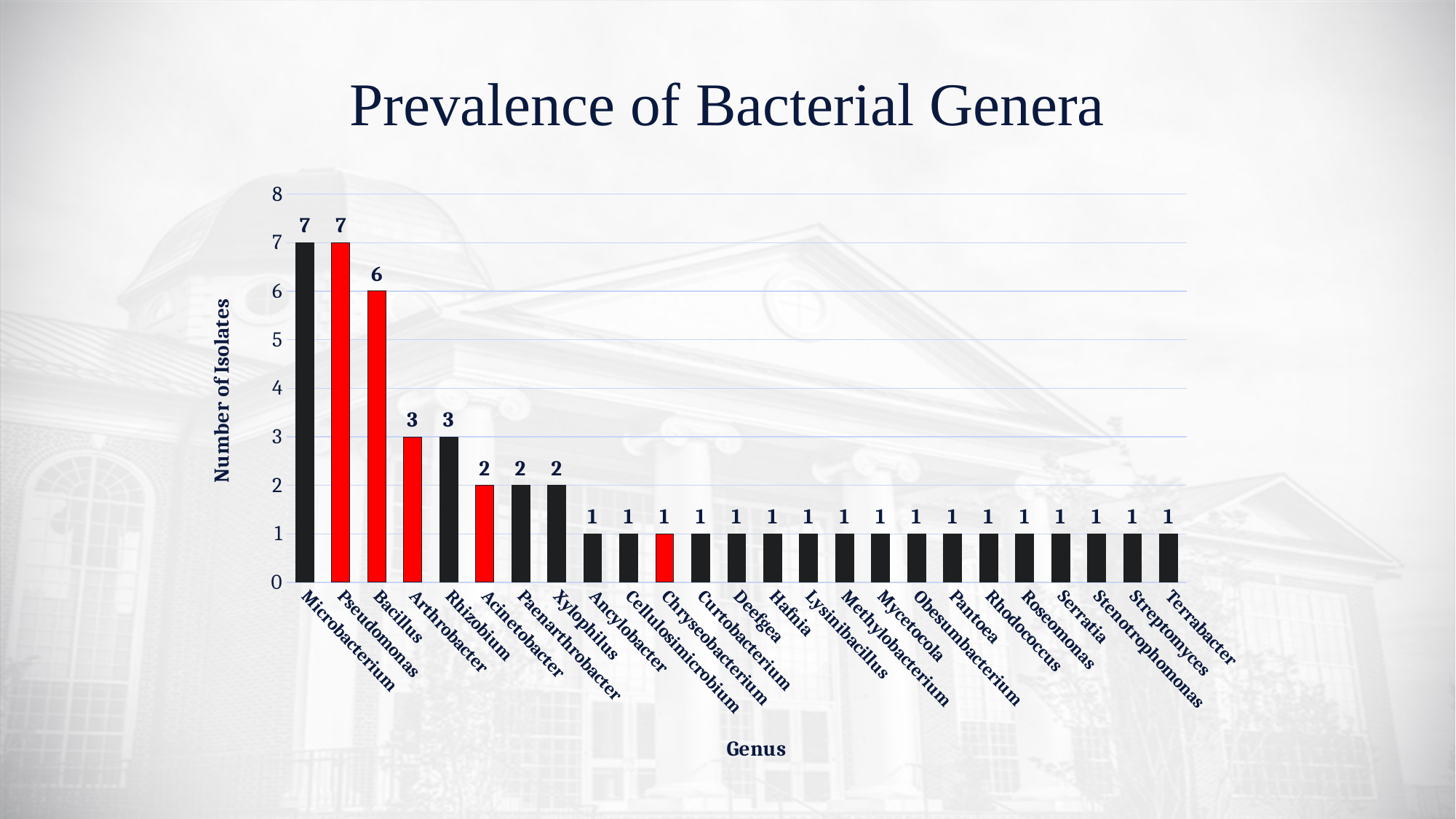
What is the difference in number of isolates between Pseudomonas and Bacillus? 1 What is the number of isolates for Rhizobium? 3 How many genera are shown on the x axis? 25 What is the title of the chart? Prevalence of Bacterial Genera How many isolates are shown for Bacillus? 6 What is the number of isolates for Streptomyces? 1 Which two genera share the highest number of isolates? Microbacterium and Pseudomonas What type of chart is shown on the slide? bar chart Which has more isolates, Acinetobacter or Hafnia? Acinetobacter What is the difference in number of isolates between Microbacterium and Arthrobacter? 4 How many isolates are shown for Paenarthrobacter? 2 What is the highest number of isolates shown for any genus? 7